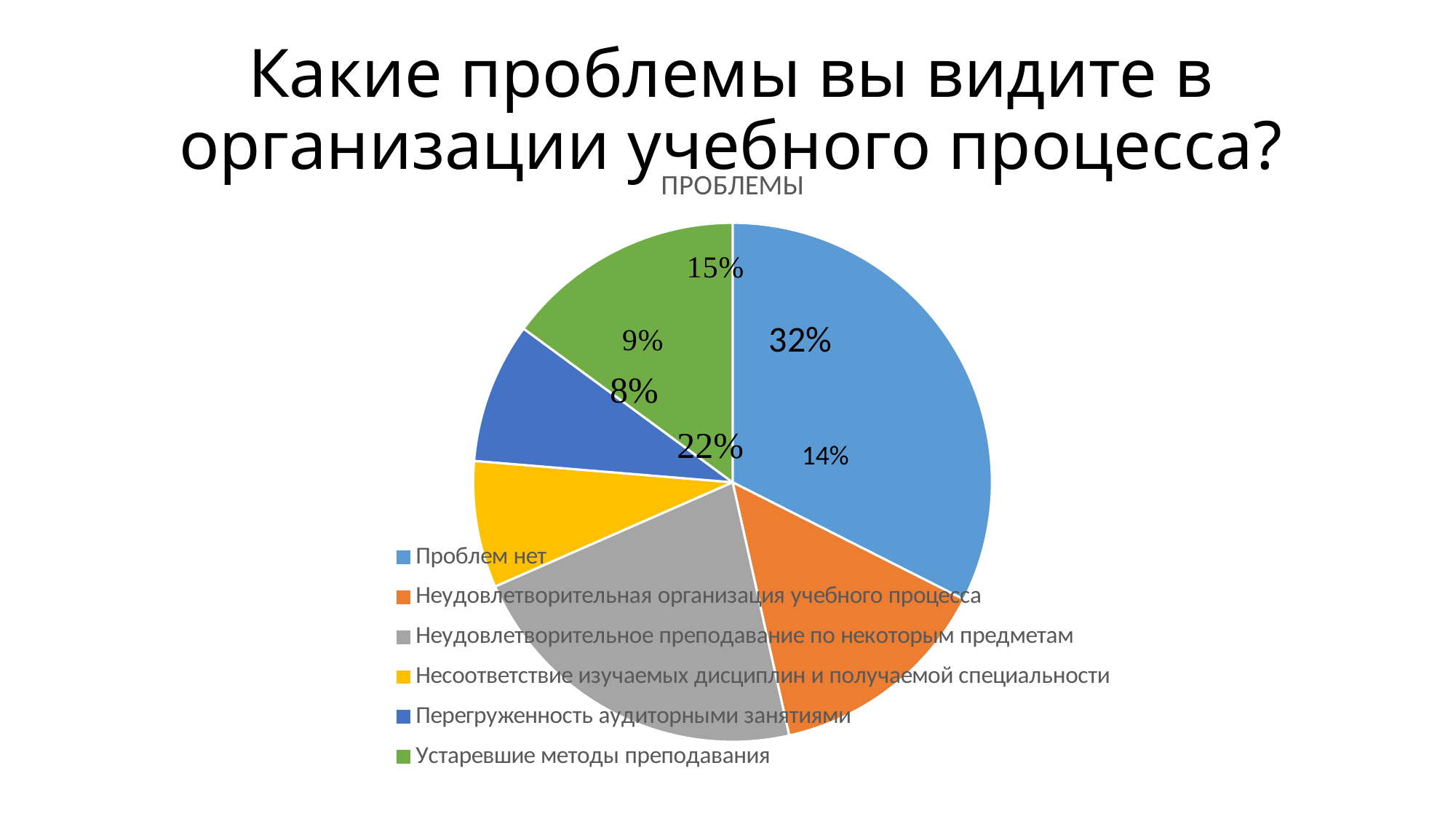
What kind of chart is shown on the slide? pie chart What colour is the slice for "Устаревшие методы преподавания"? green How many categories does the legend of the pie chart list? 6 What is the smallest percentage label shown on the pie chart? 8% Which slice is larger: "Неудовлетворительное преподавание по некоторым предметам" or "Несоответствие изучаемых дисциплин и получаемой специальности"? Неудовлетворительное преподавание по некоторым предметам What is the largest percentage label shown on the pie chart? 32% Which slice is larger: "Проблем нет" or "Неудовлетворительная организация учебного процесса"? Проблем нет Which category has the largest slice of the pie? Проблем нет What is the title of the chart? ПРОБЛЕМЫ